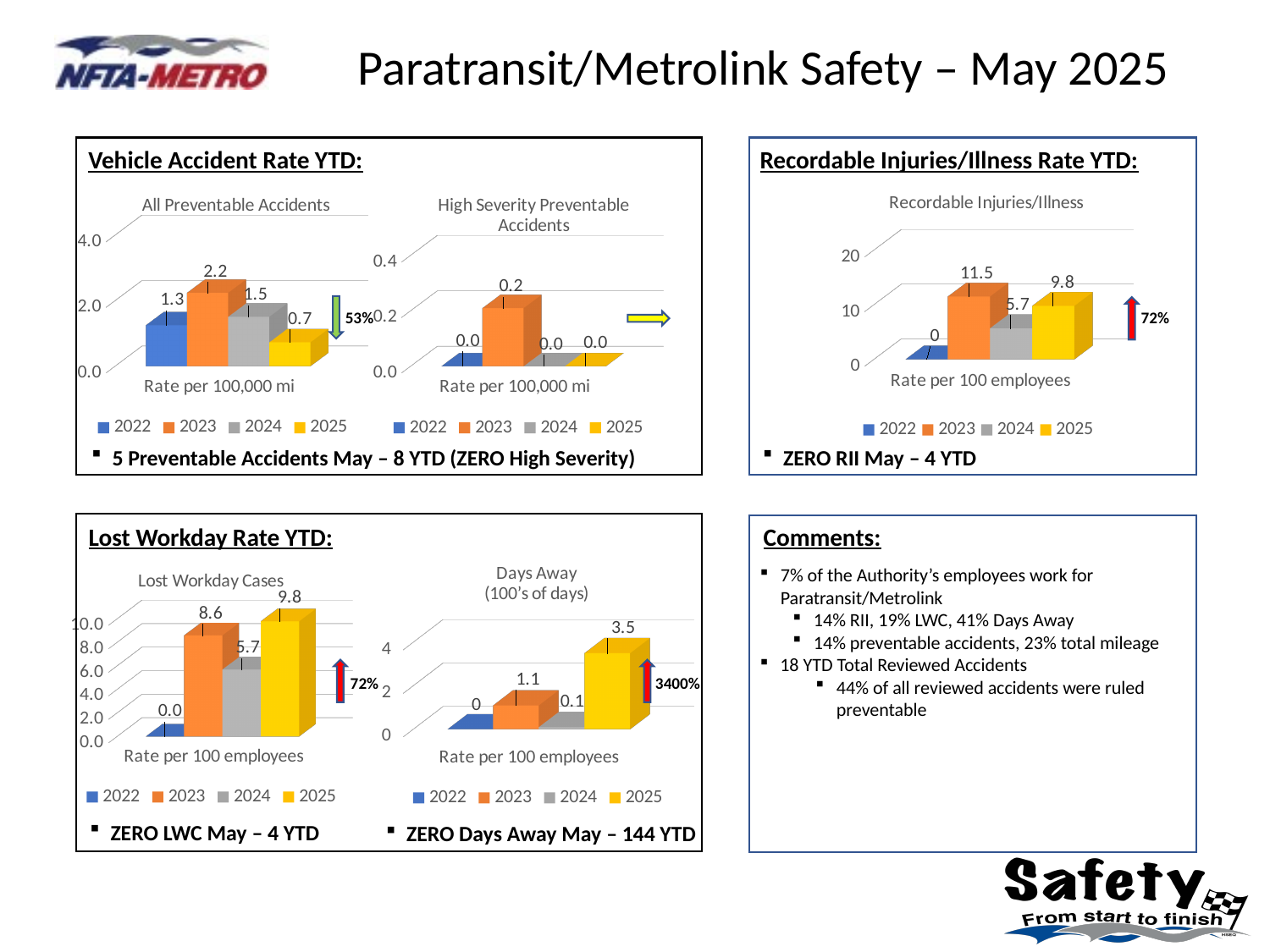
In the All Preventable Accidents chart, which year has the lowest value? 2025 In the All Preventable Accidents chart, what is the value for 2023? 2.2 In the Recordable Injuries/Illness chart, which year has the highest value? 2023 In the High Severity Preventable Accidents chart, what is the value for 2023? 0.2 In the Lost Workday Cases chart, which is larger, the value for 2023 or the value for 2025? 2025 In the Recordable Injuries/Illness chart, what is the value for 2025? 9.8 In the All Preventable Accidents chart, what is the difference between the 2023 and 2025 values? 1.5 How many series does the legend of the Lost Workday Cases chart list? 4 In the Lost Workday Cases chart, what is the value for 2024? 5.7 In the Days Away (100's of days) chart, what is the difference between the 2025 and 2023 values? 2.4 In the Days Away (100's of days) chart, what is the value for 2025? 3.5 In the Recordable Injuries/Illness chart, is the value for 2024 greater or less than 10? less